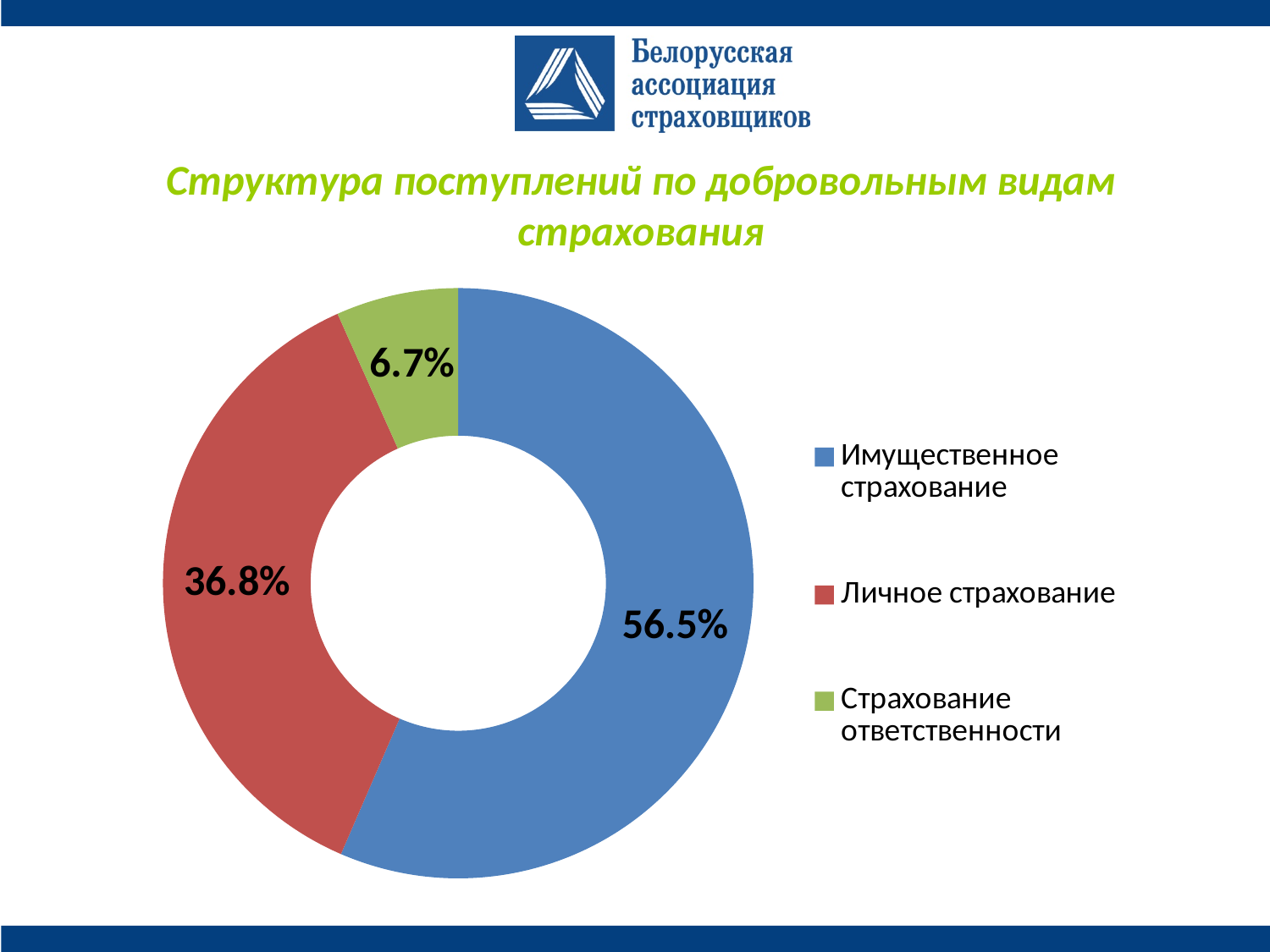
What kind of chart is shown on the slide? Doughnut (pie) chart What is the title of the chart? Структура поступлений по добровольным видам страхования Which category has the largest share? Имущественное страхование What colour represents Личное страхование in the chart? Red What share of the chart does Имущественное страхование account for? 56.5% How many categories are shown in the chart? 3 What is the difference in percentage points between Имущественное страхование and Личное страхование? 19.7 What is the value shown for Страхование ответственности? 6.7% Which category has the smallest share? Страхование ответственности What is the value shown for Личное страхование? 36.8% What is the difference in percentage points between Личное страхование and Страхование ответственности? 30.1 Which is larger, Личное страхование or Страхование ответственности? Личное страхование